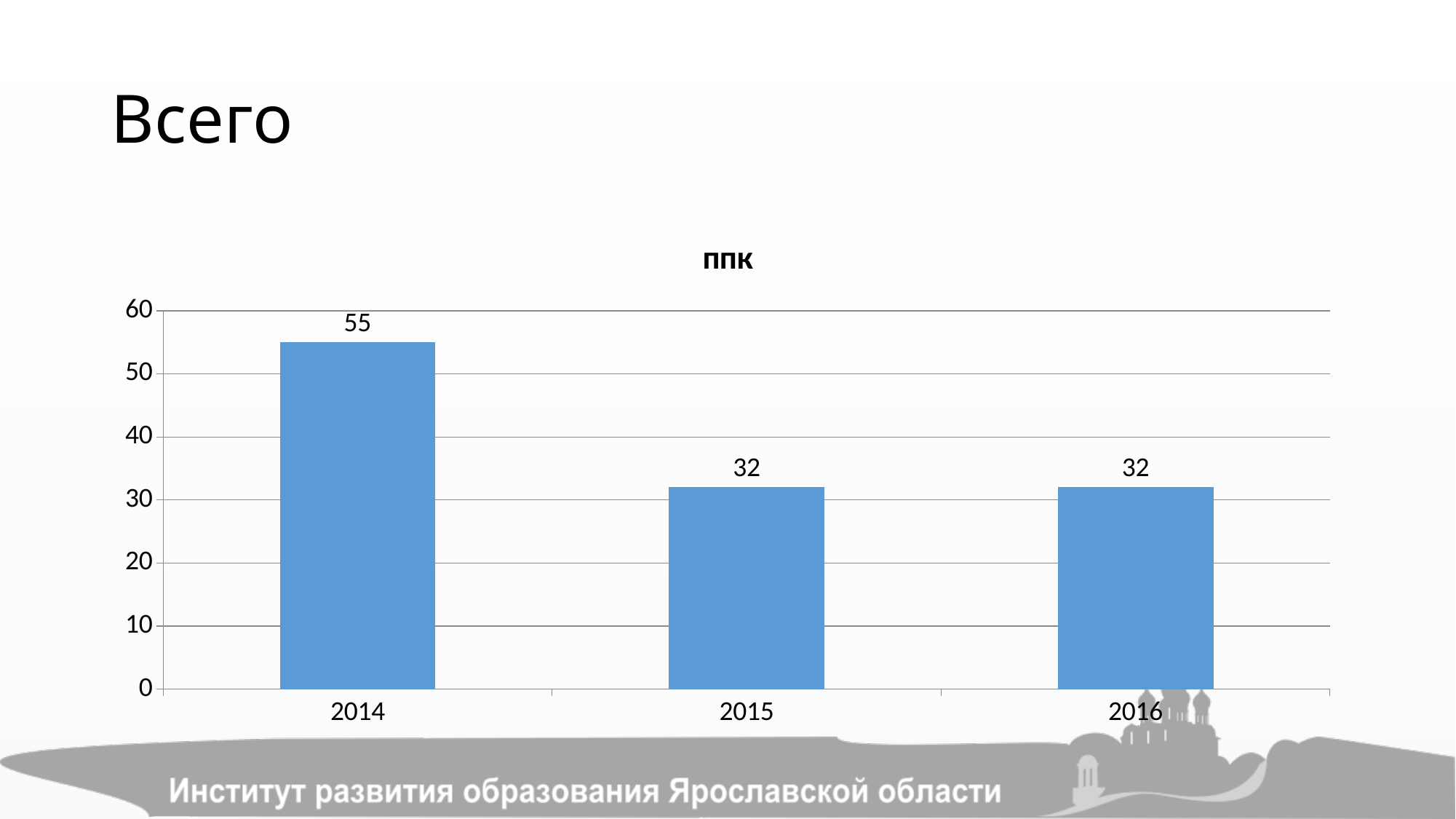
Which year has the highest value? 2014 Is the value for 2014 greater or less than 50? greater What is the value for 2015? 32 Which is larger, the value for 2014 or the value for 2016? 2014 What kind of chart is shown on the slide? bar chart What is the title of the chart? ППК How many years are shown on the x axis? 3 What is the value for 2016? 32 What is the value for 2014? 55 What is the difference between the values for 2014 and 2015? 23 Is the value for 2015 greater or less than 40? less Do the values rise or fall from 2014 to 2015? fall